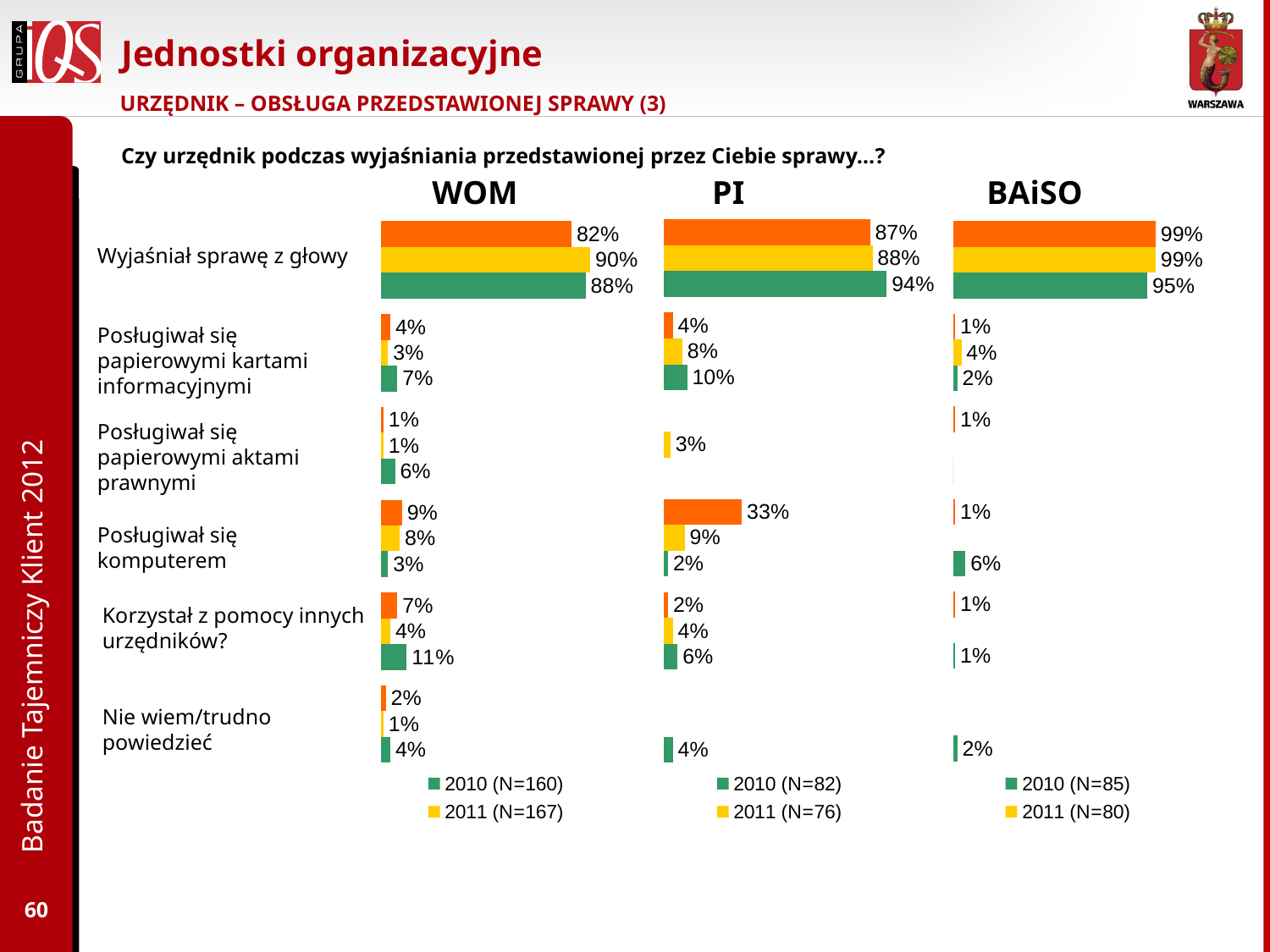
In the WOM chart, which is larger for "Posługiwał się komputerem": the 2010 value or the 2011 value? 2011 What kind of chart is the PI chart? Bar chart How many categories are shown in the BAiSO chart? 6 In the PI chart, by how many percentage points does the 2010 value for "Wyjaśniał sprawę z głowy" exceed the 2011 value? 6 percentage points In the BAiSO chart, what is the 2010 value for "Posługiwał się komputerem"? 6% In the WOM chart, what is the 2010 value for "Wyjaśniał sprawę z głowy"? 88% In the BAiSO chart, what is the 2010 value for "Wyjaśniał sprawę z głowy"? 95% In the WOM chart, which category has the highest 2010 value? Wyjaśniał sprawę z głowy In the PI chart, what is the 2011 value for "Wyjaśniał sprawę z głowy"? 88% In the WOM chart, what is the 2010 value for "Korzystał z pomocy innych urzędników?"? 11% In the PI chart, what is the 2010 value for "Posługiwał się papierowymi kartami informacyjnymi"? 10% How many series does the legend of the WOM chart list? 2